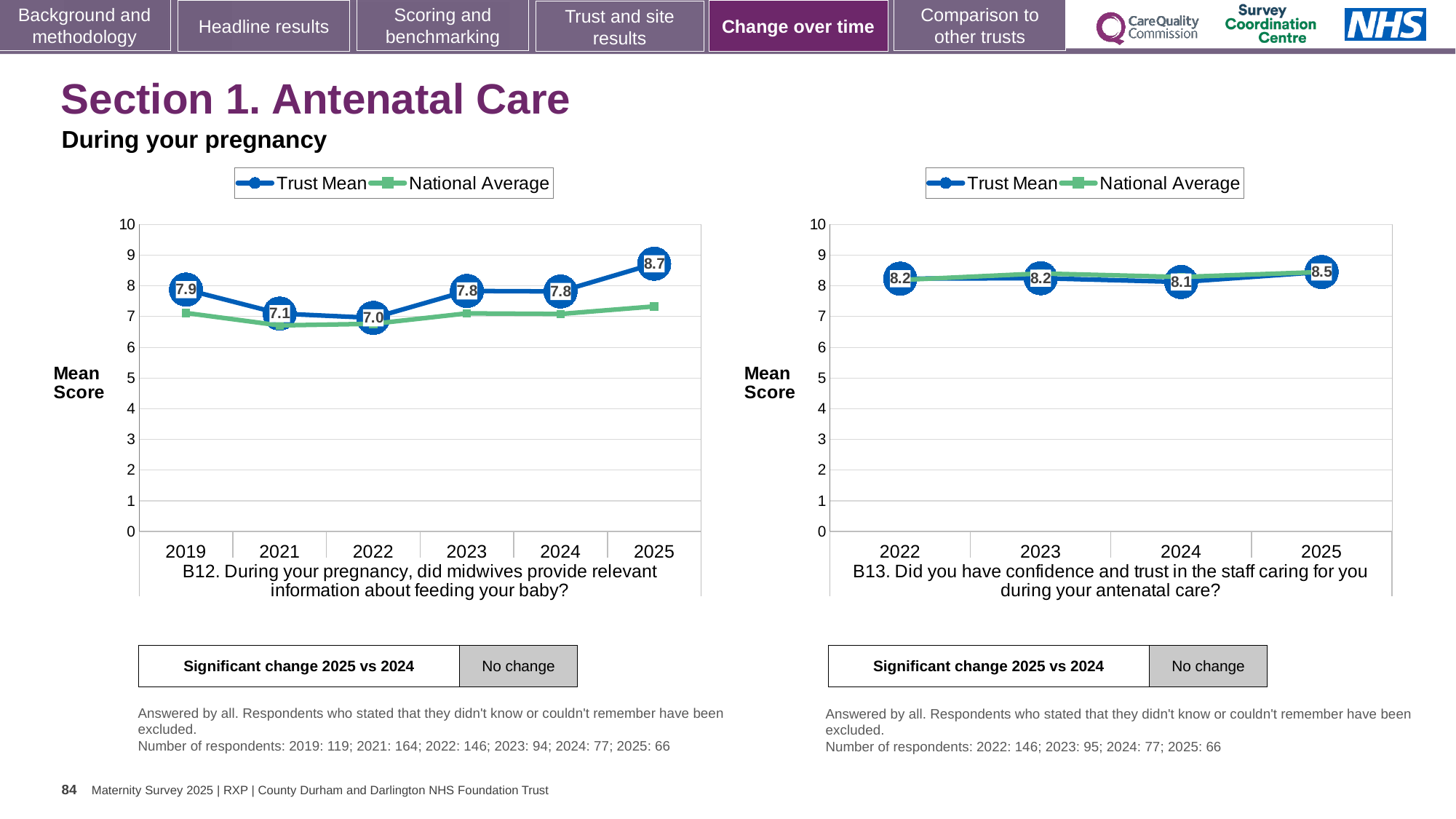
In the left chart (B12), what is the Trust Mean score for 2022? 7.0 In the left chart (B12), which year has the highest Trust Mean score? 2025 In the left chart (B12), how many years are plotted on the x axis? 6 In the left chart (B12), which year has the lowest Trust Mean score? 2022 In the left chart (B12), what is the Trust Mean score for 2025? 8.7 In the right chart (B13), how many series does the legend list? 2 In the right chart (B13), which year has the highest Trust Mean score? 2025 In the left chart (B12), what is the difference between the Trust Mean scores for 2025 and 2024? 0.9 What kind of chart is the right chart (B13)? Line chart In the right chart (B13), is the Trust Mean score for 2025 greater or less than the score for 2024? greater In the right chart (B13), what is the Trust Mean score for 2024? 8.1 In the left chart (B12), is the National Average value for 2019 greater or less than 8? less